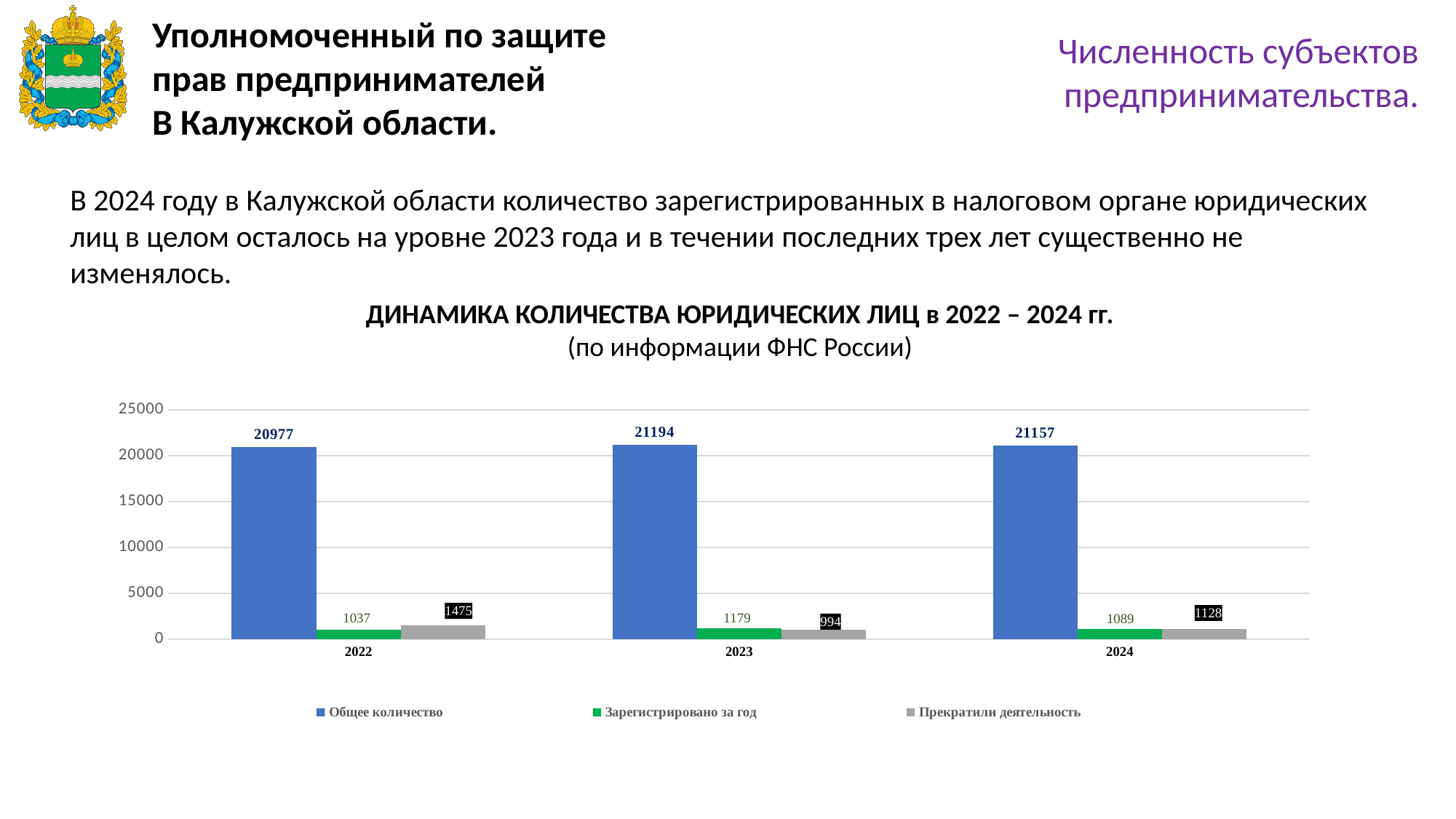
In which year is "Общее количество" highest? 2023 Which colour represents "Зарегистрировано за год" in the chart? green How many series does the legend list? 3 Is the value of "Общее количество" for 2024 greater or less than 20000? greater In which year is "Прекратили деятельность" lowest? 2023 What is the value of "Общее количество" for 2023? 21194 What is the value of "Зарегистрировано за год" for 2022? 1037 Which is larger in 2022: "Зарегистрировано за год" or "Прекратили деятельность"? Прекратили деятельность How many years are shown on the x axis? 3 What is the value of "Прекратили деятельность" for 2024? 1128 What kind of chart is shown? bar chart What is the difference between "Общее количество" in 2023 and in 2022? 217